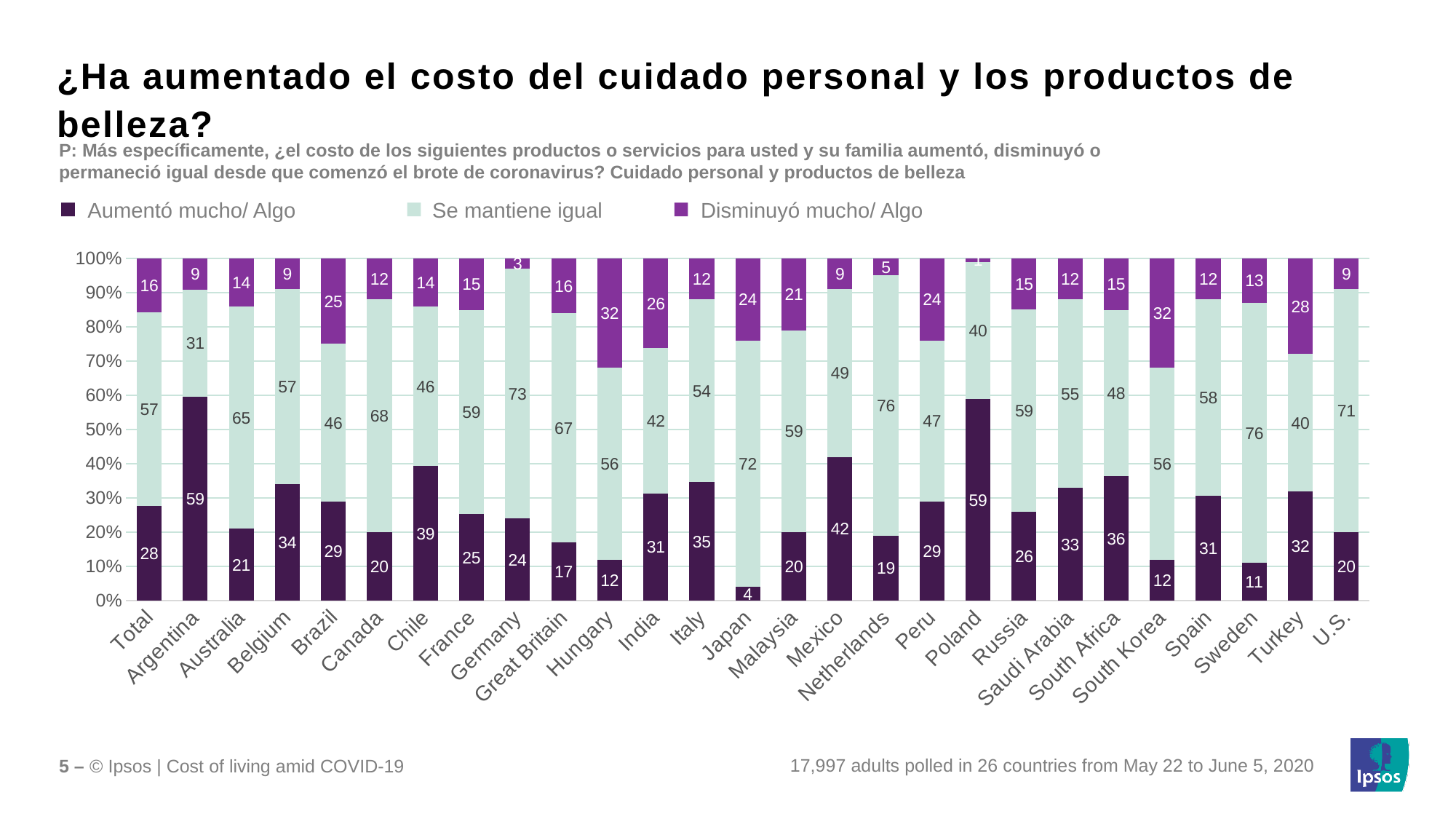
Which country has the lowest 'Se mantiene igual' value? Argentina What percentage of respondents in Mexico said the cost of personal care and beauty products 'Aumentó mucho/ Algo'? 42 Which country has the lowest 'Aumentó mucho/ Algo' value? Japan What kind of chart is shown on the slide? Stacked bar chart How many series does the legend list? 3 Which legend entry is shown in the lightest colour? Se mantiene igual What is the 'Aumentó mucho/ Algo' value for the Total bar? 28 What is the 'Se mantiene igual' value for Germany? 73 What is the difference between the 'Aumentó mucho/ Algo' values for Chile and Canada? 19 How many categories (including Total) are shown on the x axis? 27 Which has a larger 'Disminuyó mucho/ Algo' value, Brazil or India? India What is the 'Disminuyó mucho/ Algo' value for Turkey? 28